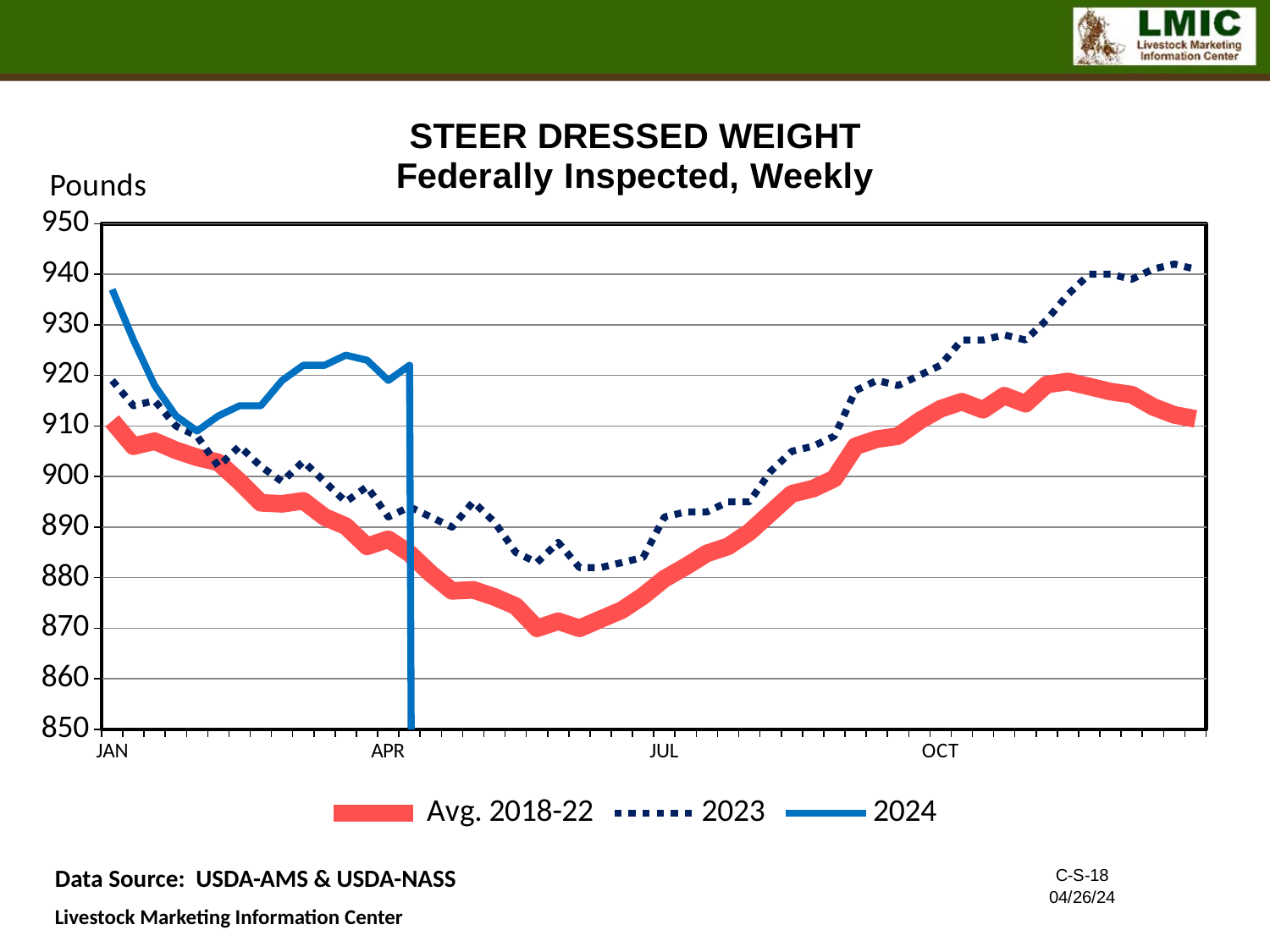
Does the Avg. 2018-22 series rise or fall from January to July? fall Which series reaches the highest value on the chart? 2023 Is the value of the 2024 series at the start of January greater or less than 930? greater Is the lowest value of the Avg. 2018-22 series greater or less than 880? less What unit is shown on the y axis of the chart? Pounds Around April, which series is higher: 2024 or Avg. 2018-22? 2024 Is the value of the 2023 series at the start of January greater or less than 910? greater What kind of chart is shown on the slide? line chart What are the three series listed in the legend? Avg. 2018-22, 2023, 2024 At the start of January, which series is higher: 2024 or 2023? 2024 How many series does the legend list? 3